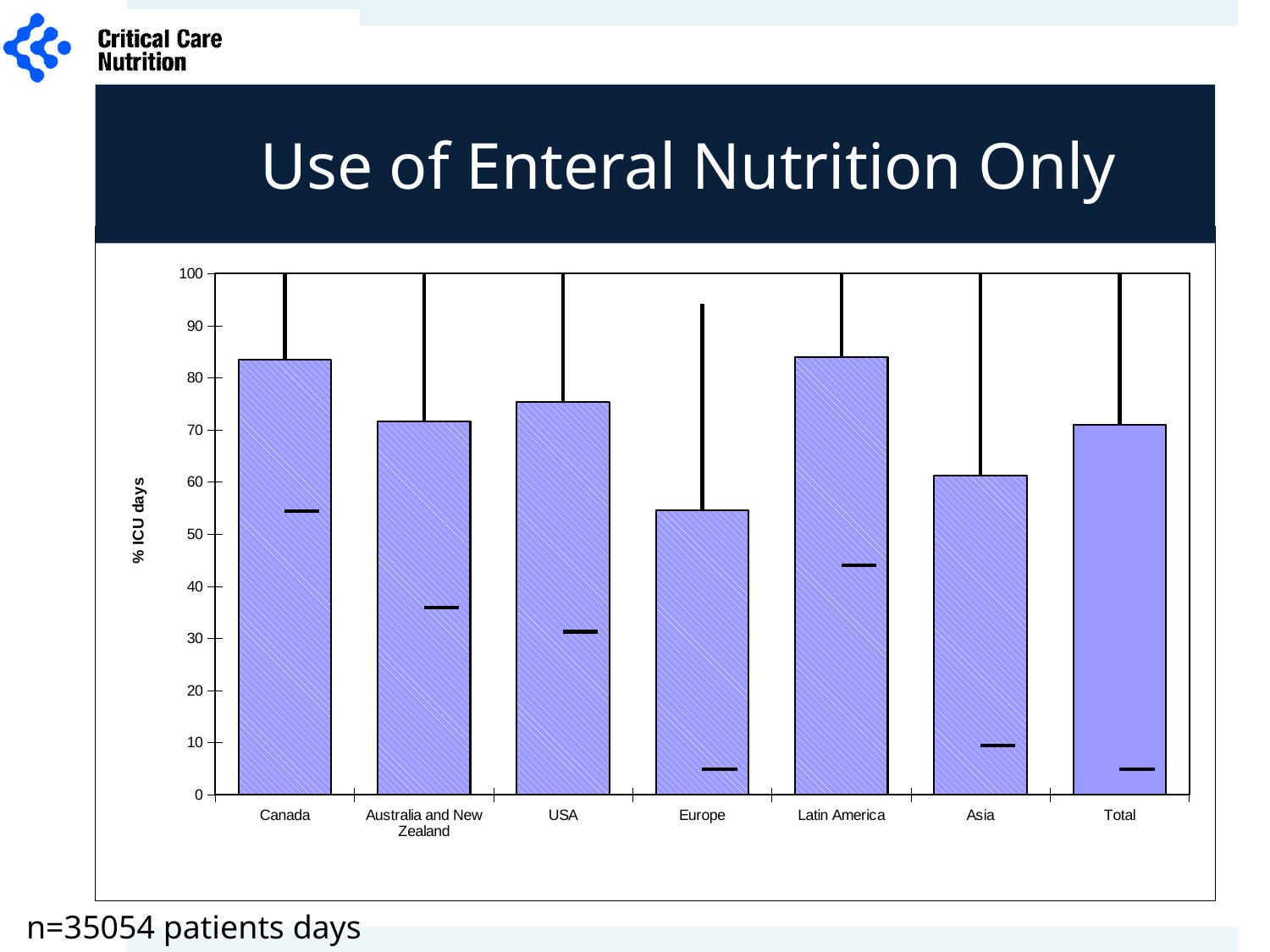
Is the value for Canada greater or less than 80? greater What is the label on the vertical axis of the chart? % ICU days How many categories are shown on the x axis of the chart? 7 Is the value for Latin America greater or less than 80? greater Which category has the lowest bar in the chart? Europe Is the value for Asia greater or less than 70? less Which has the larger bar, USA or Europe? USA What is the title of the chart? Use of Enteral Nutrition Only What kind of chart is shown on the slide? bar chart Which has the larger bar, Asia or Canada? Canada